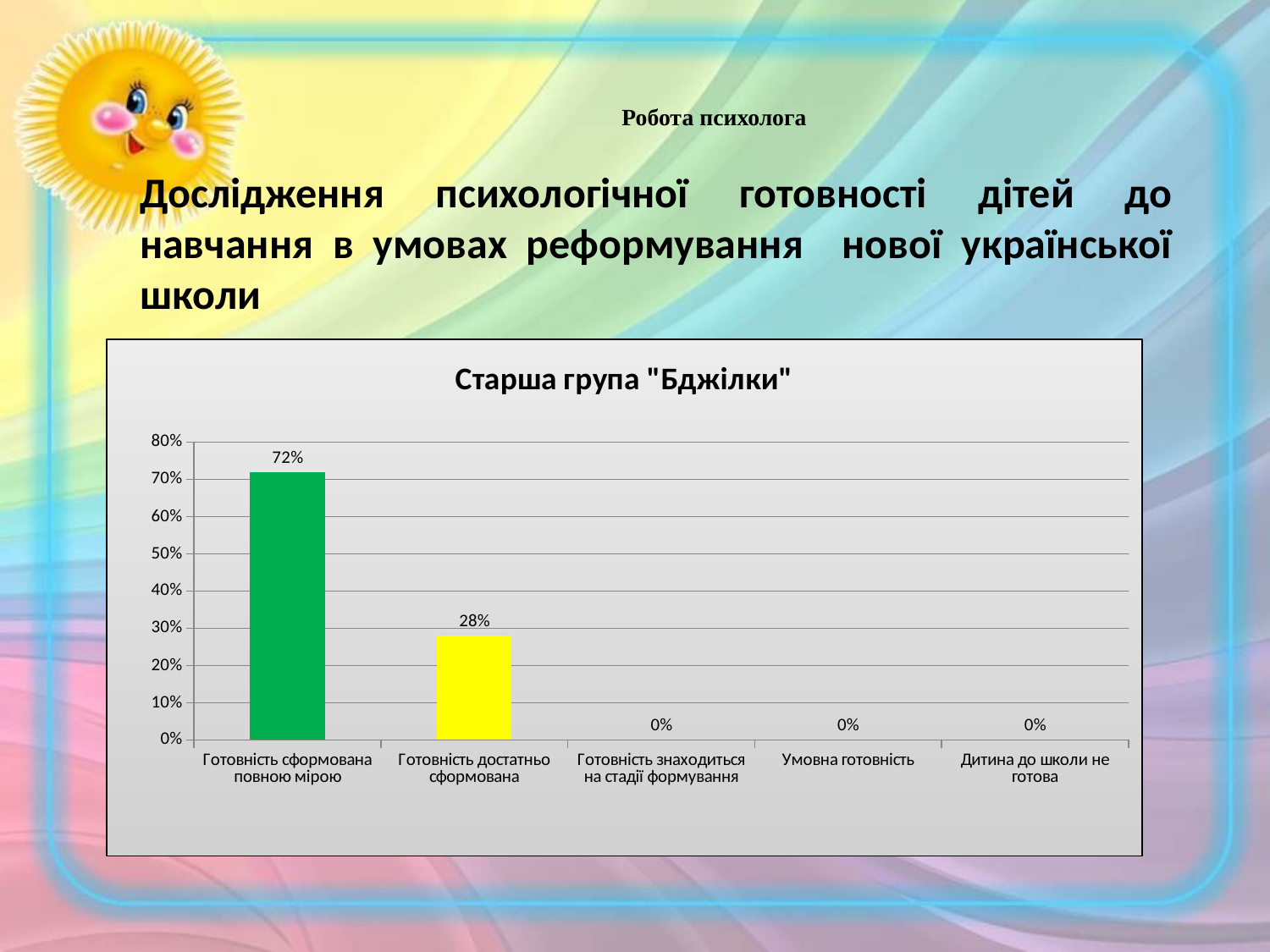
What is the value for "Умовна готовність"? 0% What is the value for "Готовність достатньо сформована"? 28% How many categories are shown on the x axis? 5 What kind of chart is shown? bar chart How many categories have a value of 0%? 3 What is the title of the chart? Старша група "Бджілки" What is the value for "Готовність сформована повною мірою"? 72% Which category has the highest value? Готовність сформована повною мірою Do the values rise or fall from left to right along the x axis? fall Is the value for "Готовність сформована повною мірою" greater or less than 50%? greater Which is larger: "Готовність достатньо сформована" or "Дитина до школи не готова"? Готовність достатньо сформована What is the difference between "Готовність сформована повною мірою" and "Готовність достатньо сформована"? 44%